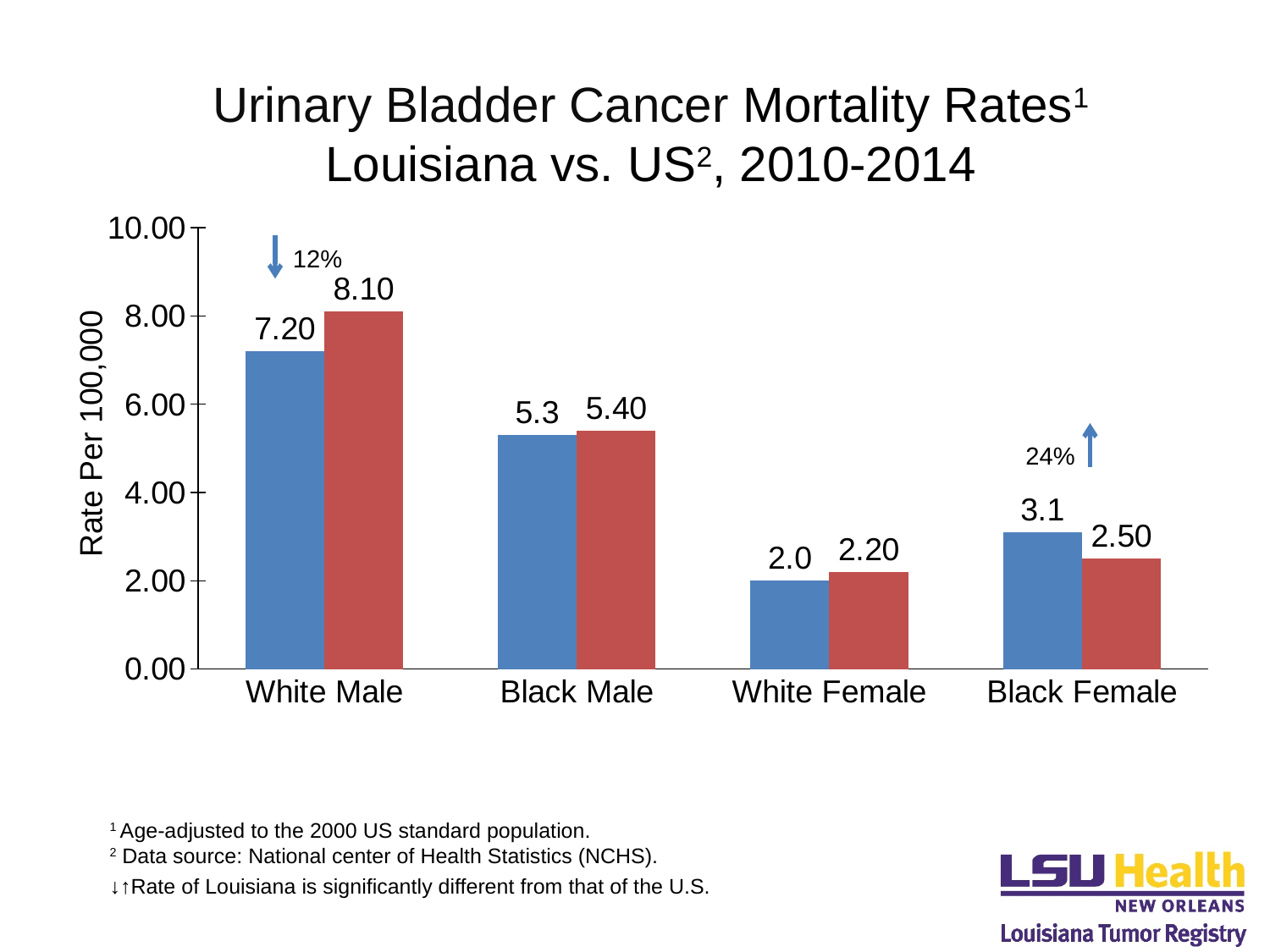
What is the value of the blue bar for Black Male? 5.3 Is the value of the red bar for Black Male greater or less than 4.00? greater What percentage is annotated above the Black Female bars? 24% What is the value of the blue bar for White Male? 7.20 For Black Female, which bar is larger, the blue bar or the red bar? the blue bar What is the title of the y axis? Rate Per 100,000 What is the difference between the red bar and the blue bar for White Male? 0.90 What kind of chart is shown on the slide? bar chart How many categories are shown on the x axis? 4 Which category has the highest red bar? White Male Which category has the lowest blue bar? White Female What is the value of the red bar for Black Female? 2.50